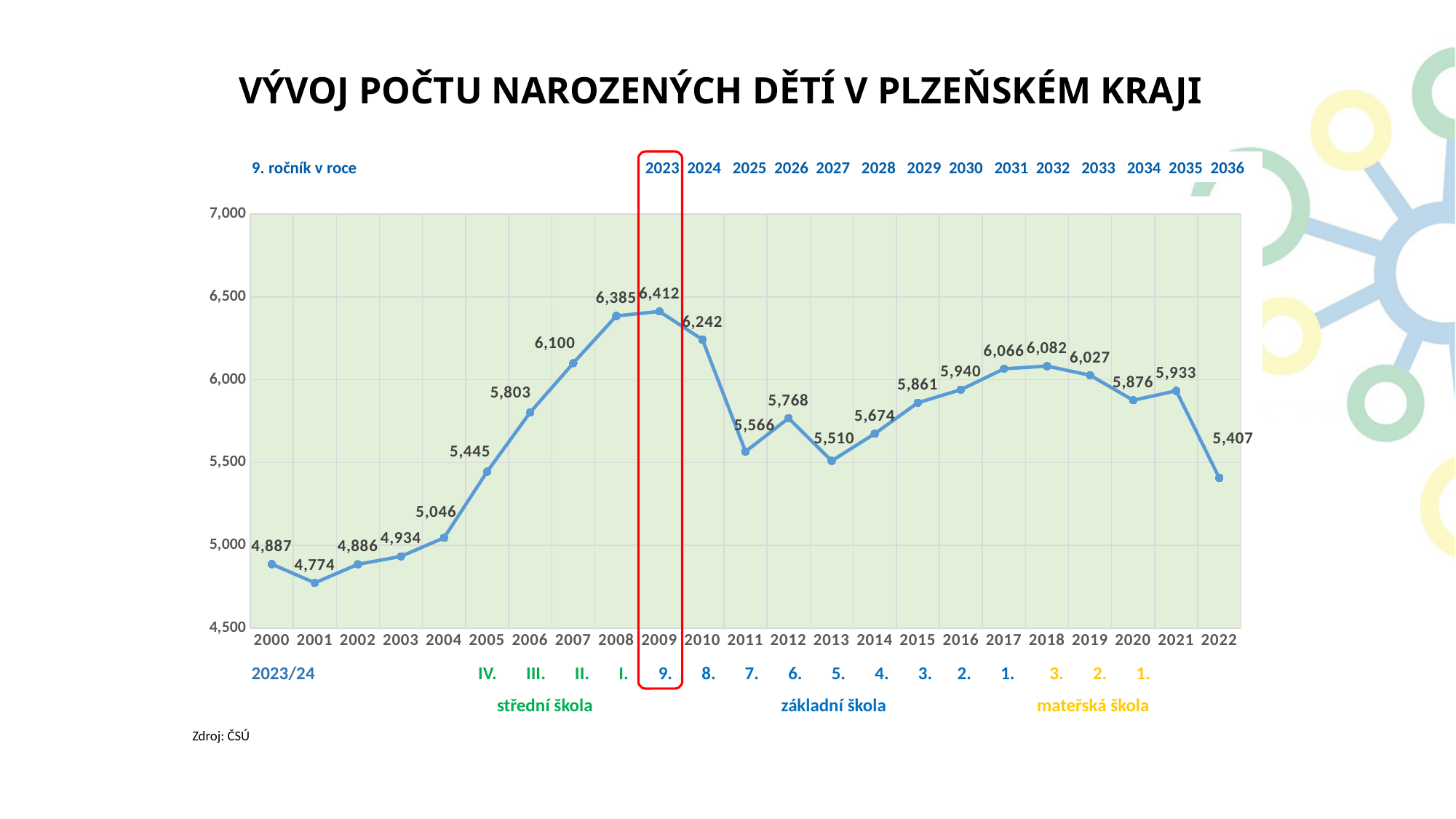
What is the difference between the values for 2010 and 2011? 676 Do the values rise or fall from 2004 to 2009? rise Which is larger, the value for 2007 or the value for 2013? 2007 Which year has the highest value? 2009 What kind of chart is shown on the slide? line chart What is the value for 2001? 4,774 Is the value for 2005 greater or less than 5,500? less How many years are plotted on the chart? 23 What is the difference between the values for 2009 and 2022? 1,005 What is the value for 2022? 5,407 What is the value for 2009? 6,412 Which year has the lowest value? 2001